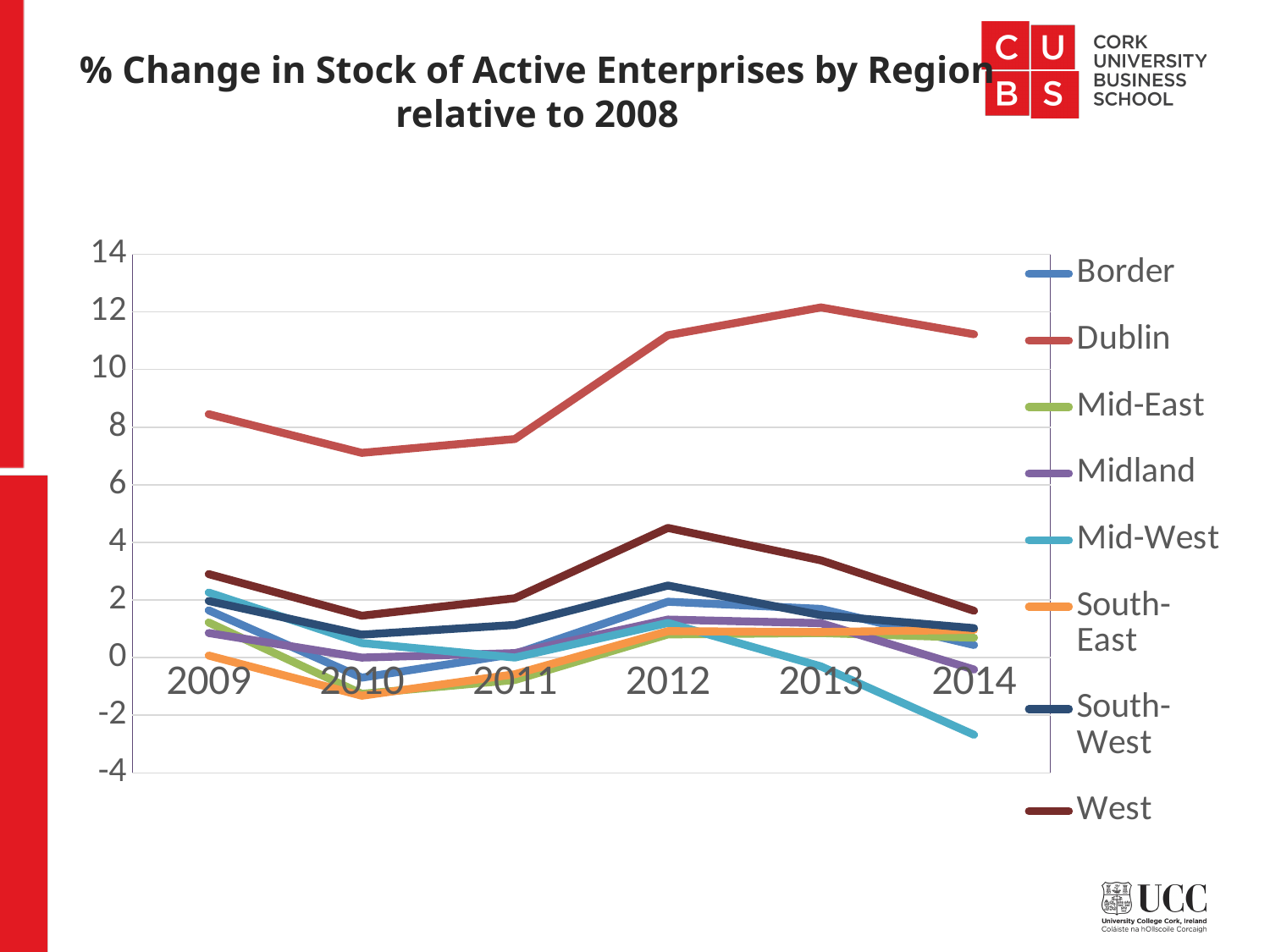
In 2012, which is larger: the value for Dublin or the value for West? Dublin Does the Dublin line rise or fall from 2010 to 2013? rise Which region has the lowest value in 2014? Mid-West How many series does the legend list? 8 How many years are shown along the x axis? 6 Is the value for Mid-West in 2014 greater or less than -2? less Which region has the highest value in 2013? Dublin Is the value for Dublin in 2012 greater or less than 10? greater What is the title of the chart? % Change in Stock of Active Enterprises by Region relative to 2008 What kind of chart is shown on the slide? line chart Is the value for Dublin in 2010 greater or less than 8? less